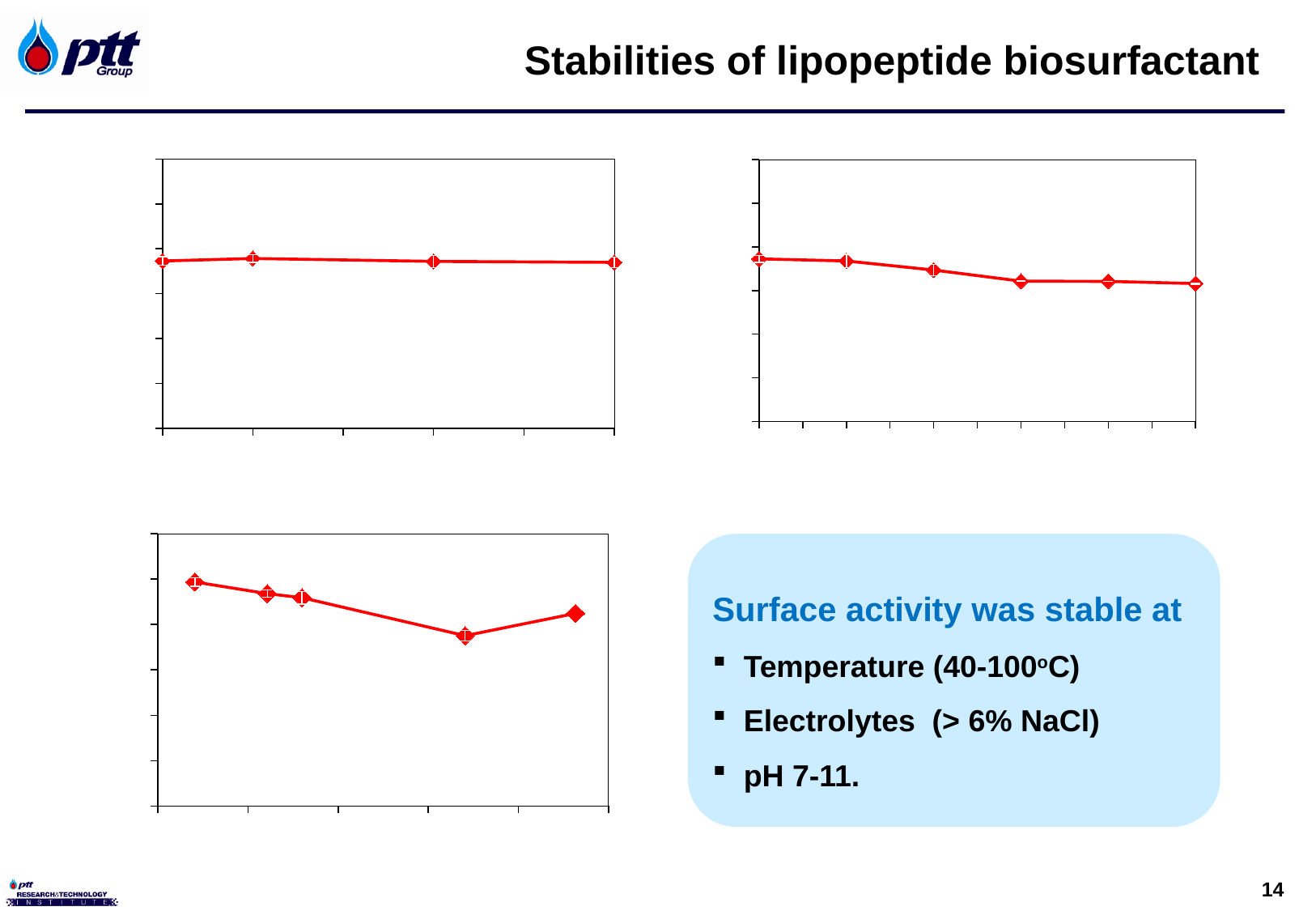
On the top-right chart, do the values rise or fall along the x axis? fall On the top-left chart, do the values rise, fall or stay roughly flat along the x axis? stay roughly flat What kind of chart is the top-right chart on the slide? line chart What colour are the lines plotted on the charts? red What kind of chart is the top-left chart on the slide? line chart How many data points are plotted on the bottom-left chart? 5 How many charts are shown on the slide? 3 How many data points are plotted on the top-right chart? 6 On the bottom-left chart, is the last point higher or lower than the first point? lower How many data points are plotted on the top-left chart? 4 What kind of chart is the bottom-left chart on the slide? line chart On the bottom-left chart, is the last point higher or lower than the fourth point? higher